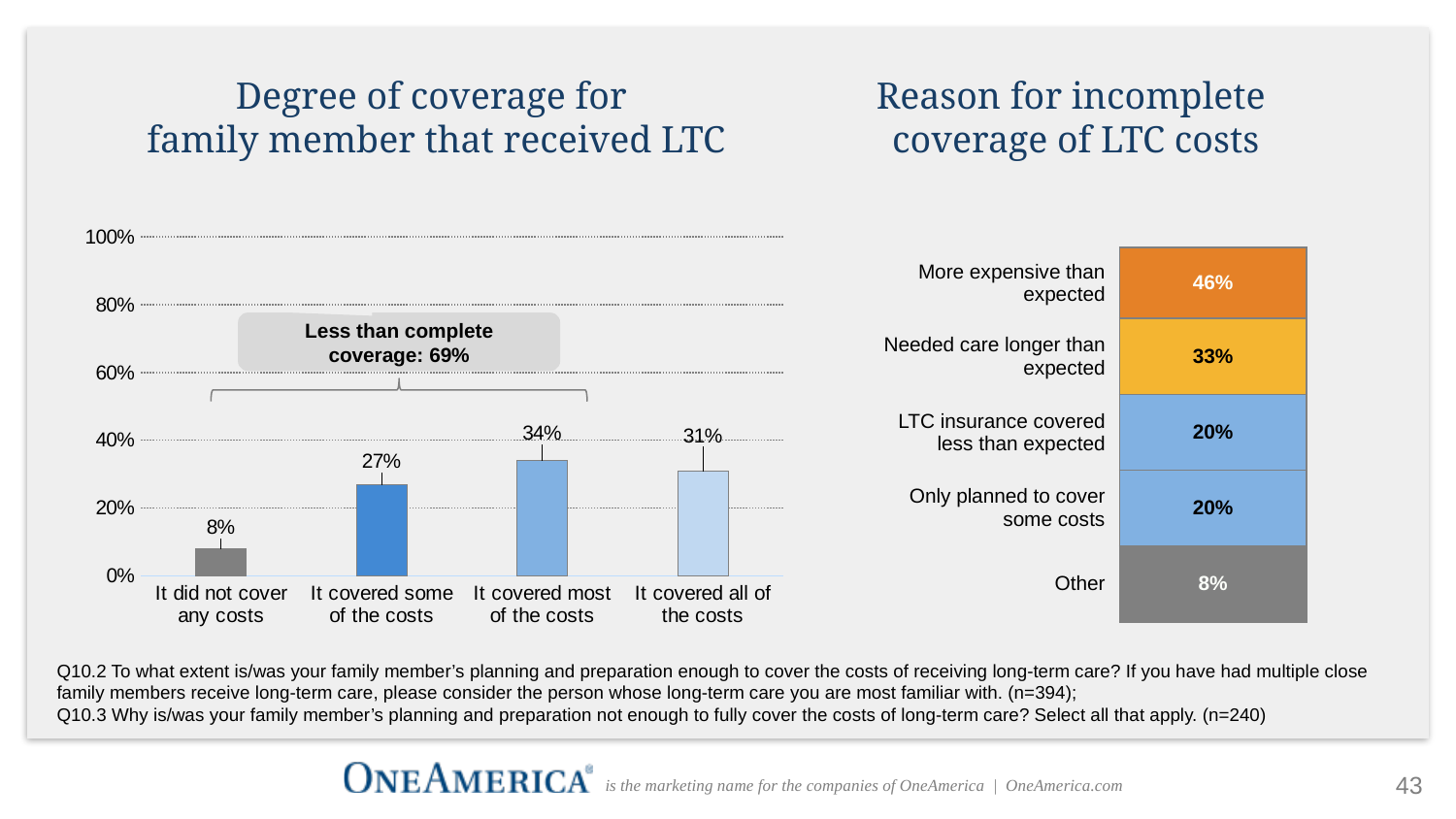
In the 'Degree of coverage for family member that received LTC' chart, which category has the lowest value? It did not cover any costs In the 'Degree of coverage for family member that received LTC' chart, how many categories are shown on the x axis? 4 In the 'Degree of coverage for family member that received LTC' chart, what is the value for 'It did not cover any costs'? 8% In the 'Degree of coverage for family member that received LTC' chart, which category has the highest value? It covered most of the costs In the 'Reason for incomplete coverage of LTC costs' chart, what is the value for 'More expensive than expected'? 46% In the 'Degree of coverage for family member that received LTC' chart, what percentage is labelled as 'Less than complete coverage'? 69% What kind of chart is the 'Degree of coverage for family member that received LTC' chart? Bar chart In the 'Degree of coverage for family member that received LTC' chart, what is the difference between 'It covered most of the costs' and 'It covered all of the costs'? 3% In the 'Reason for incomplete coverage of LTC costs' chart, which reason has the lowest value? Other In the 'Degree of coverage for family member that received LTC' chart, what is the value for 'It covered some of the costs'? 27% In the 'Reason for incomplete coverage of LTC costs' chart, what is the value for 'Needed care longer than expected'? 33% In the 'Reason for incomplete coverage of LTC costs' chart, is the value for 'More expensive than expected' larger or smaller than the value for 'Needed care longer than expected'? Larger